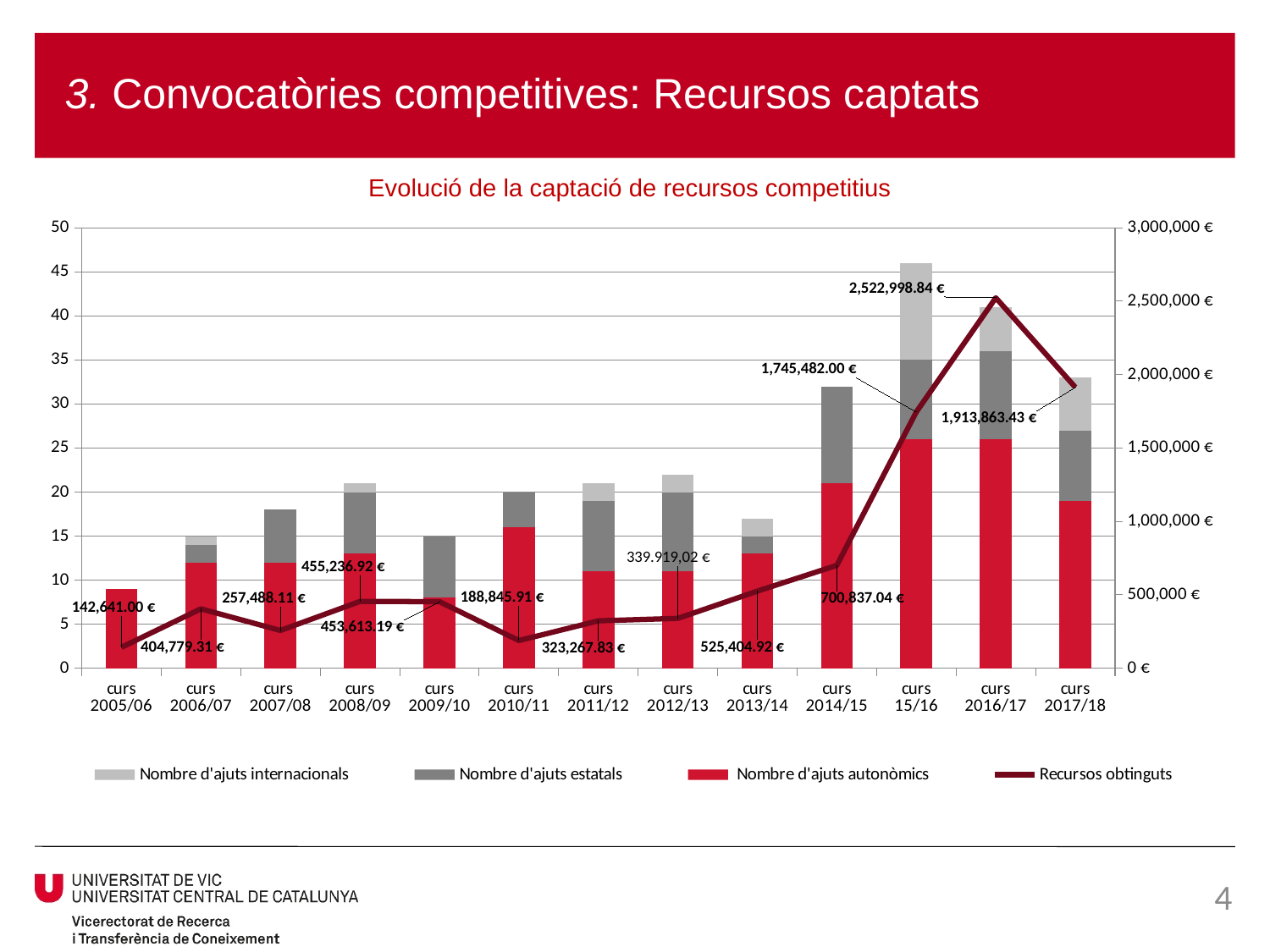
How many series does the legend list? 4 What value does the Recursos obtinguts line show for curs 2016/17? 2,522,998.84 € What kind of chart is shown on the slide? Combination of a stacked bar chart and a line chart What value does the Recursos obtinguts line show for curs 2013/14? 525,404.92 € How many curs categories are shown on the x axis? 13 What is the difference between the Recursos obtinguts values for curs 2016/17 and curs 2017/18? 609,135.41 € In which curs is the Recursos obtinguts value lowest? curs 2005/06 Is the Nombre d'ajuts autonòmics value for curs 2017/18 greater or less than 15? greater Which has a larger Recursos obtinguts value, curs 2006/07 or curs 2007/08? curs 2006/07 What value does the Recursos obtinguts line show for curs 2005/06? 142,641.00 € In which curs is the Recursos obtinguts value highest? curs 2016/17 Is the total height of the stacked bar for curs 15/16 greater or less than 40? greater